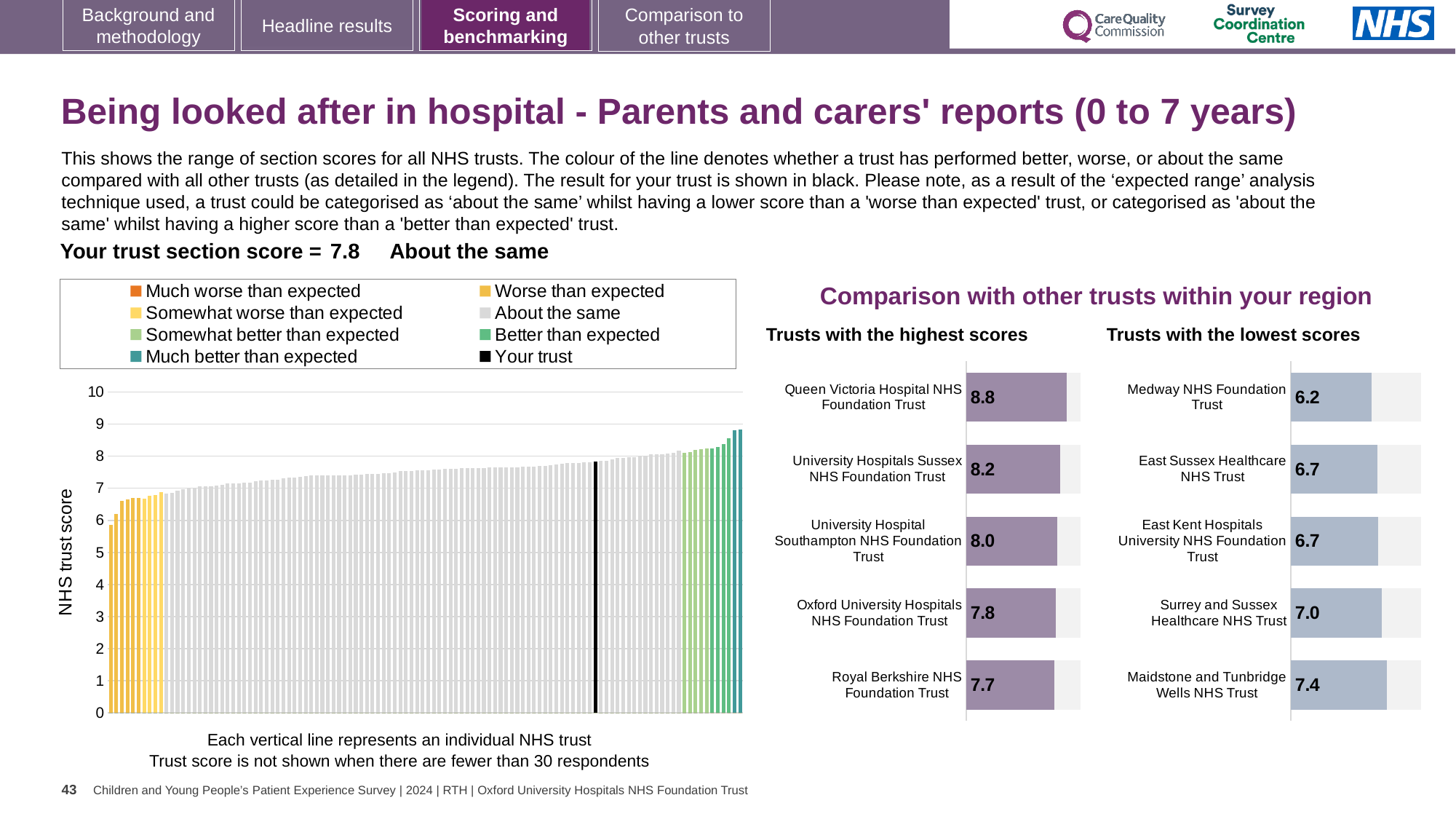
How many trusts are shown in the 'Trusts with the lowest scores' chart? 5 In the NHS trust score chart on the left, do the bars rise or fall from left to right? Rise In the 'Trusts with the lowest scores' chart, which trust has the lowest score? Medway NHS Foundation Trust In the 'Trusts with the highest scores' chart, which trust has the highest score? Queen Victoria Hospital NHS Foundation Trust In the 'Trusts with the lowest scores' chart, which has the larger score: Surrey and Sussex Healthcare NHS Trust or Maidstone and Tunbridge Wells NHS Trust? Maidstone and Tunbridge Wells NHS Trust What kind of chart is the NHS trust score chart on the left of the slide? Bar chart In the NHS trust score chart on the left, is the value of the tallest bar greater or less than 8? greater In the 'Trusts with the highest scores' chart, what is the difference between the scores of Queen Victoria Hospital NHS Foundation Trust and Royal Berkshire NHS Foundation Trust? 1.1 In the 'Trusts with the lowest scores' chart, what is the score for Medway NHS Foundation Trust? 6.2 How many entries does the legend of the NHS trust score chart list? 8 In the 'Trusts with the highest scores' chart, what is the score for Queen Victoria Hospital NHS Foundation Trust? 8.8 In the 'Trusts with the highest scores' chart, what is the score for Oxford University Hospitals NHS Foundation Trust? 7.8